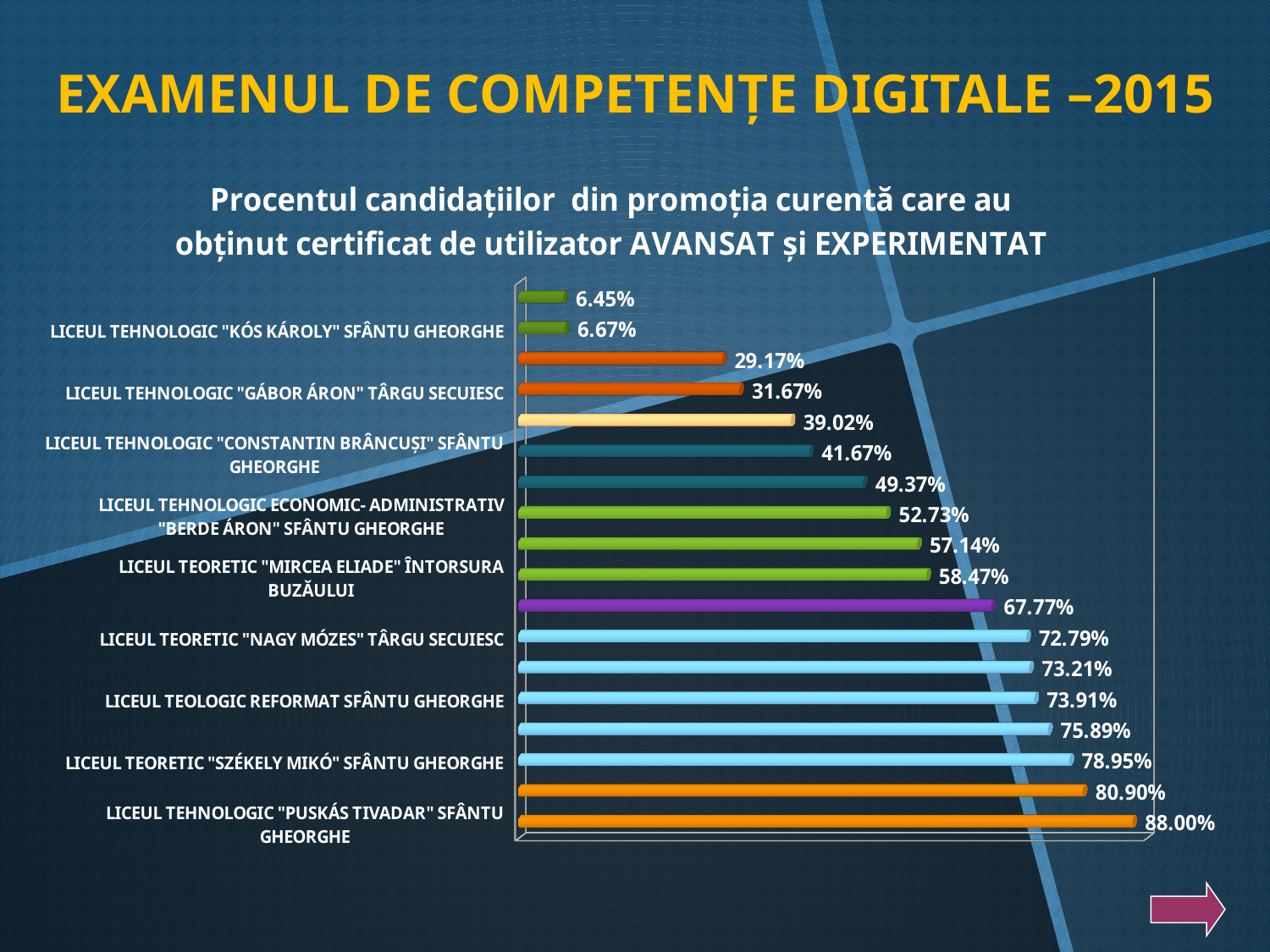
How many bars are plotted in the chart? 18 What is the value for LICEUL TEHNOLOGIC "KÓS KÁROLY" SFÂNTU GHEORGHE? 6.67% What kind of chart is shown on the slide? bar chart Which is larger: the value for LICEUL TEORETIC "SZÉKELY MIKÓ" SFÂNTU GHEORGHE or the value for LICEUL TEORETIC "NAGY MÓZES" TÂRGU SECUIESC? LICEUL TEORETIC "SZÉKELY MIKÓ" SFÂNTU GHEORGHE What is the difference between the two largest values in the chart, 88.00% and 80.90%? 7.10 percentage points What is the value for LICEUL TEHNOLOGIC "PUSKÁS TIVADAR" SFÂNTU GHEORGHE? 88.00% What is the lowest value shown in the chart? 6.45% What is the highest value shown in the chart? 88.00% What is the value for LICEUL TEORETIC "SZÉKELY MIKÓ" SFÂNTU GHEORGHE? 78.95% Do the bar values increase or decrease going from the top of the chart to the bottom? increase What is the value for LICEUL TEORETIC "NAGY MÓZES" TÂRGU SECUIESC? 72.79% What is the title of the chart? Procentul candidațiilor din promoția curentă care au obținut certificat de utilizator AVANSAT și EXPERIMENTAT